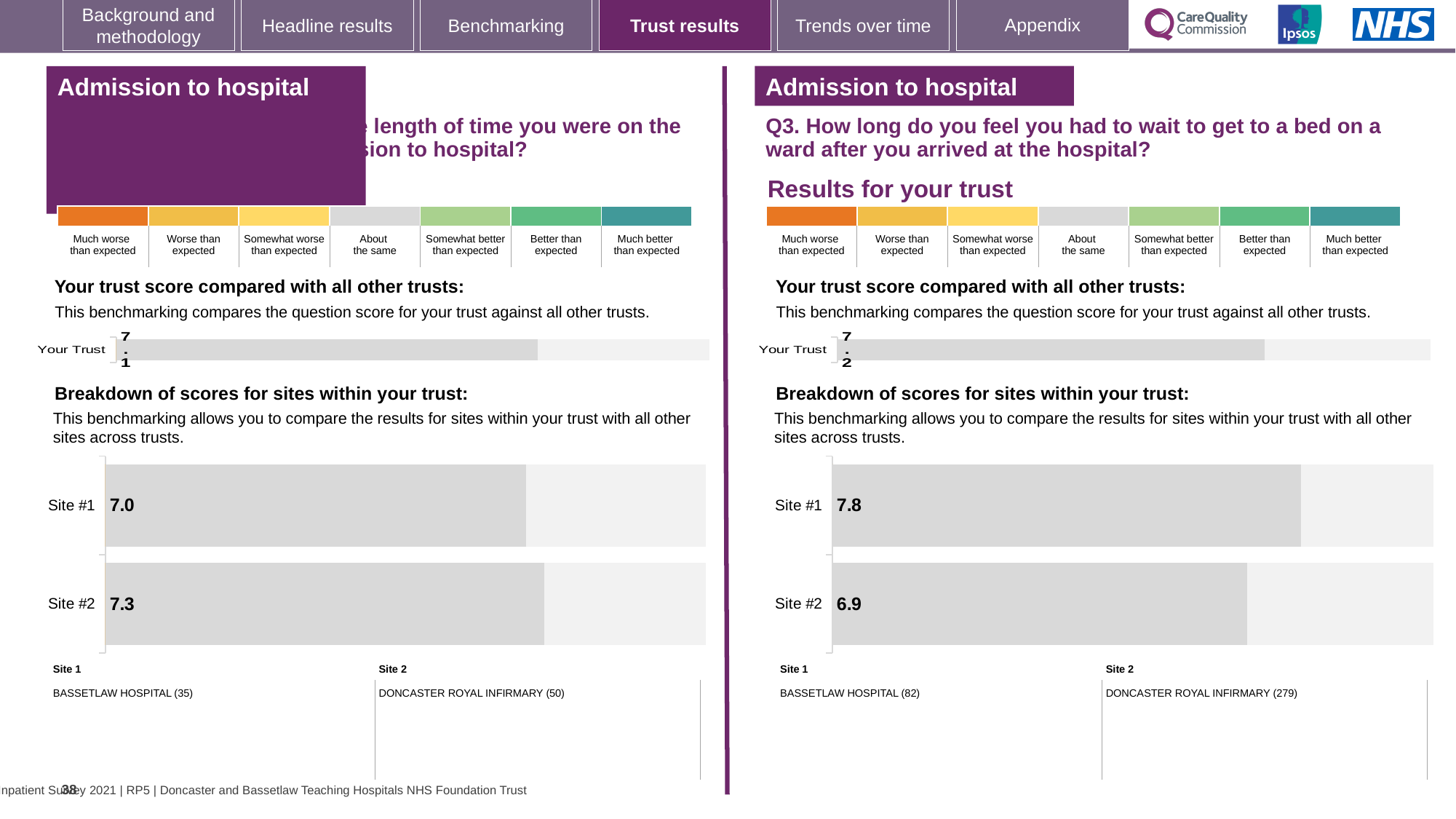
How many sites are shown in the left-hand site breakdown chart? 2 On the right-hand 'Your Trust' chart (Q3), what is the trust score shown? 7.2 On the right-hand site breakdown chart (Q3), which site has the higher score? Site #1 On the left-hand site breakdown chart, what is the score for Site #1? 7.0 On the left-hand 'Your Trust' chart, what is the trust score shown? 7.1 On the left-hand site breakdown chart, what is the score for Site #2? 7.3 On the left-hand site breakdown chart, what is the difference between the Site #2 and Site #1 scores? 0.3 On the right-hand site breakdown chart (Q3), what is the difference between the Site #1 and Site #2 scores? 0.9 What type of chart is used for the site breakdown on the right-hand side of the slide? Bar chart On the left-hand site breakdown chart, which site has the lower score? Site #1 On the right-hand site breakdown chart (Q3), what is the score for Site #1? 7.8 On the right-hand site breakdown chart (Q3), what is the score for Site #2? 6.9